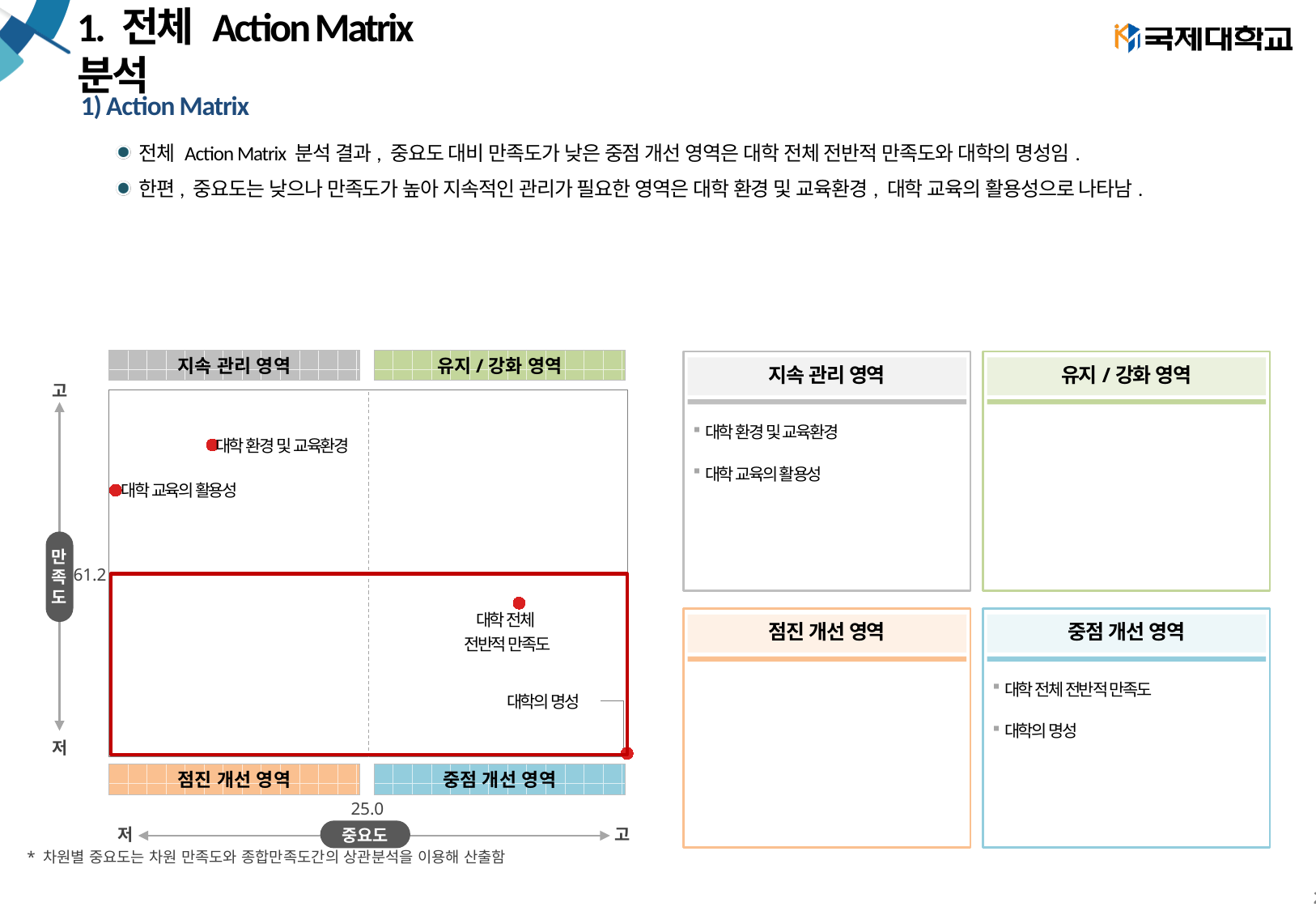
In the Action Matrix, which has the higher 중요도: 대학의 명성 or 대학 교육의 활용성? 대학의 명성 How many data points are plotted in the Action Matrix? 4 What is the value of the horizontal reference line on the 만족도 axis of the Action Matrix? 61.2 Which point in the Action Matrix has the lowest 만족도? 대학의 명성 In the Action Matrix, is the 만족도 value for 대학 환경 및 교육환경 greater or less than 61.2? greater In the Action Matrix, is the 만족도 value for 대학의 명성 greater or less than 61.2? less In the Action Matrix, is the 중요도 value for 대학 전체 전반적 만족도 greater or less than 25.0? greater Which point in the Action Matrix has the highest 만족도? 대학 환경 및 교육환경 What kind of chart is the Action Matrix on the slide? scatter chart What is the value of the vertical reference line on the 중요도 axis of the Action Matrix? 25.0